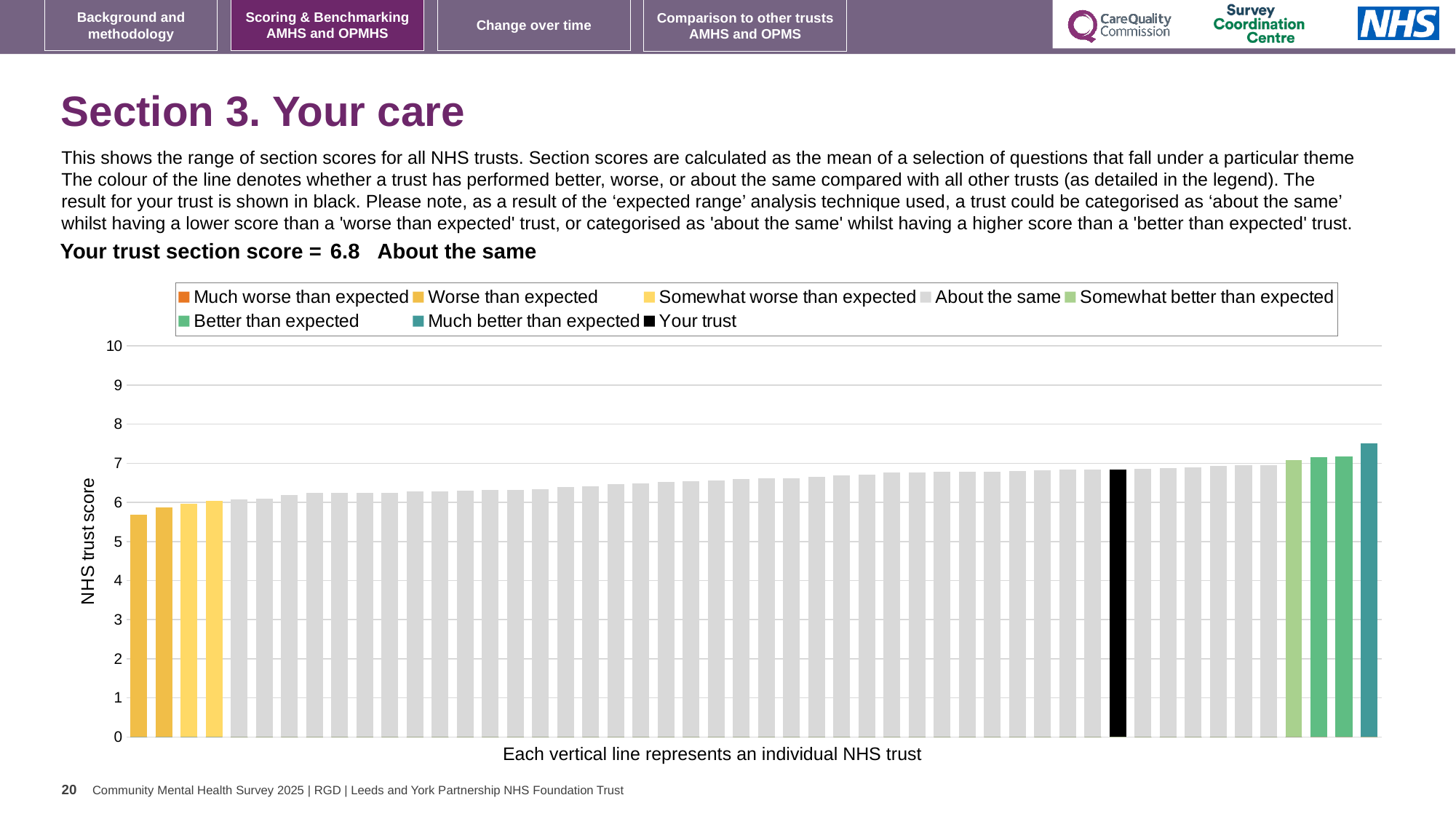
Which benchmarking category is your trust placed in for Section 3. Your care? About the same What is the section score for your trust shown on the slide? 6.8 What colour is the bar representing your trust? Black Which legend category does the tallest bar on the right of the chart belong to? Much better than expected How many entries does the chart legend list? 8 Is the value of the highest bar in the chart greater or less than 7? greater Do the bar values rise or fall from left to right along the x axis? Rise Is the value of the lowest bar in the chart greater or less than 6? less What kind of chart is shown on the slide? Bar chart What is the label on the vertical axis of the chart? NHS trust score Is the value of the black bar (your trust) greater or less than 6? greater